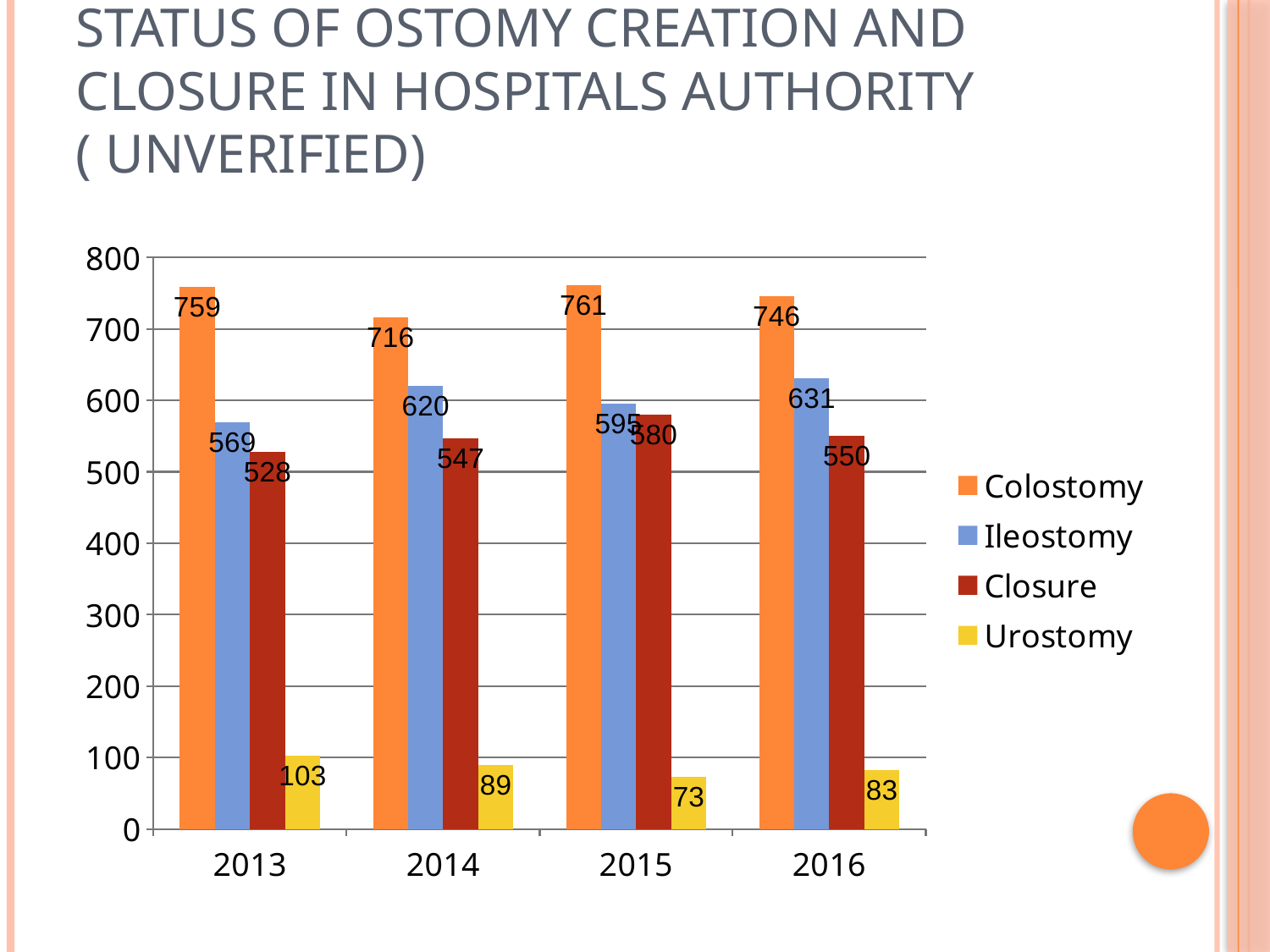
How many years are shown on the x axis? 4 What is the Colostomy value for 2013? 759 What kind of chart is shown on the slide? Bar chart How many series does the legend list? 4 Which is larger in 2016, the Ileostomy value or the Closure value? Ileostomy What is the Closure value for 2015? 580 Which colour represents Urostomy in the legend? Yellow What is the Urostomy value for 2014? 89 What is the Ileostomy value for 2016? 631 In which year is the Urostomy value lowest? 2015 What is the difference between the Colostomy and Ileostomy values in 2014? 96 In which year is the Colostomy value highest? 2015